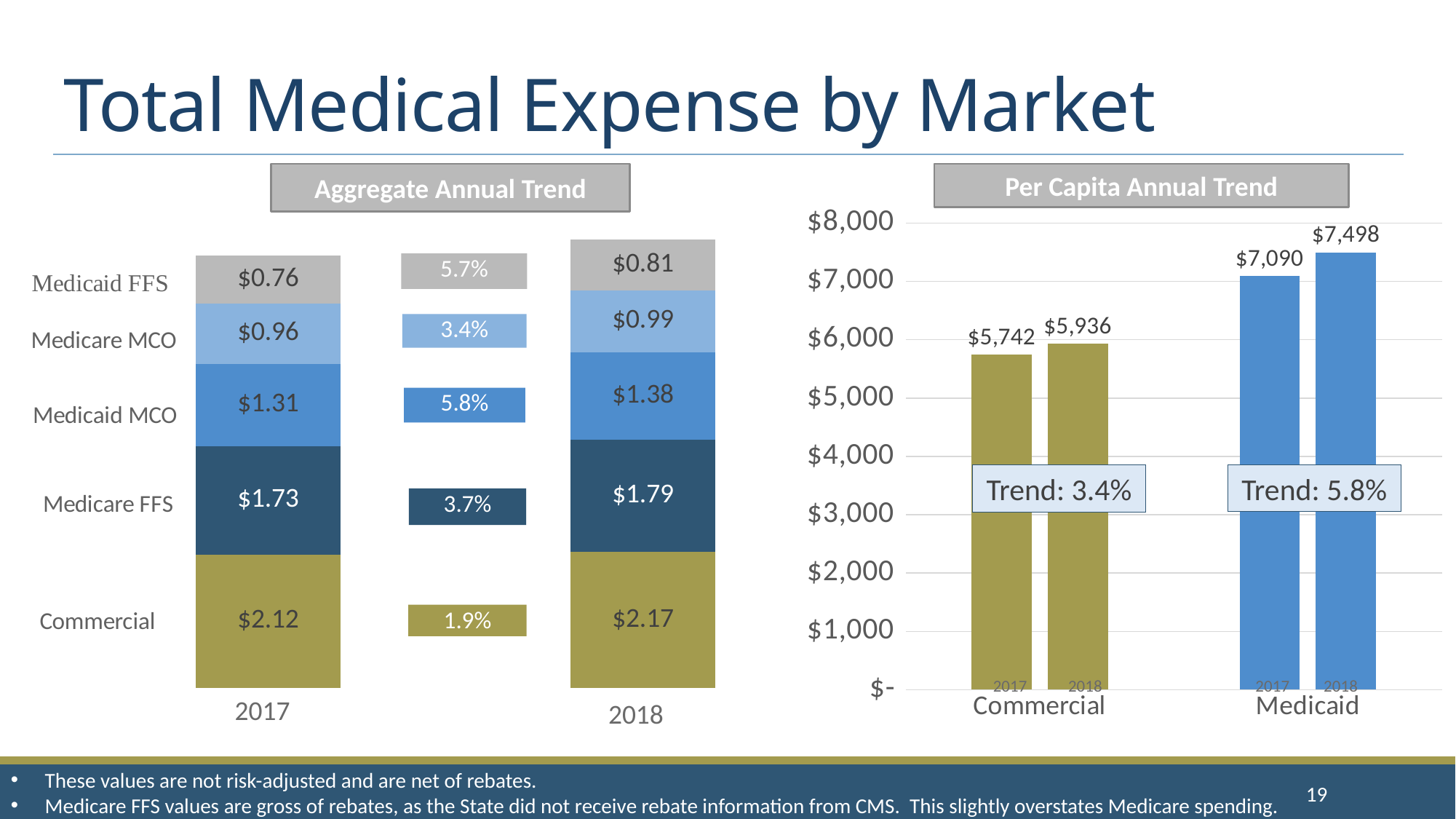
In the Per Capita Annual Trend chart, what is the Medicaid value for 2018? $7,498 In the Aggregate Annual Trend chart, what is the Medicaid MCO value for 2018? $1.38 What kind of chart is the Aggregate Annual Trend chart? Stacked bar chart In the Per Capita Annual Trend chart, what trend percentage is shown for Commercial? 3.4% In the Per Capita Annual Trend chart, which is larger: Commercial 2018 or Medicaid 2017? Medicaid 2017 In the Aggregate Annual Trend chart, what is the Commercial value for 2017? $2.12 In the Aggregate Annual Trend chart, which segment has the smallest value in the 2017 bar? Medicaid FFS In the Aggregate Annual Trend chart, what annual trend percentage is shown for Medicare FFS? 3.7% In the Aggregate Annual Trend chart, what is the total of the 2017 stacked bar? $6.88 In the Aggregate Annual Trend chart, how many segments make up each stacked bar? 5 In the Aggregate Annual Trend chart, which segment has the largest value in the 2018 bar? Commercial In the Per Capita Annual Trend chart, what is the difference between the Medicaid 2018 and 2017 values? $408